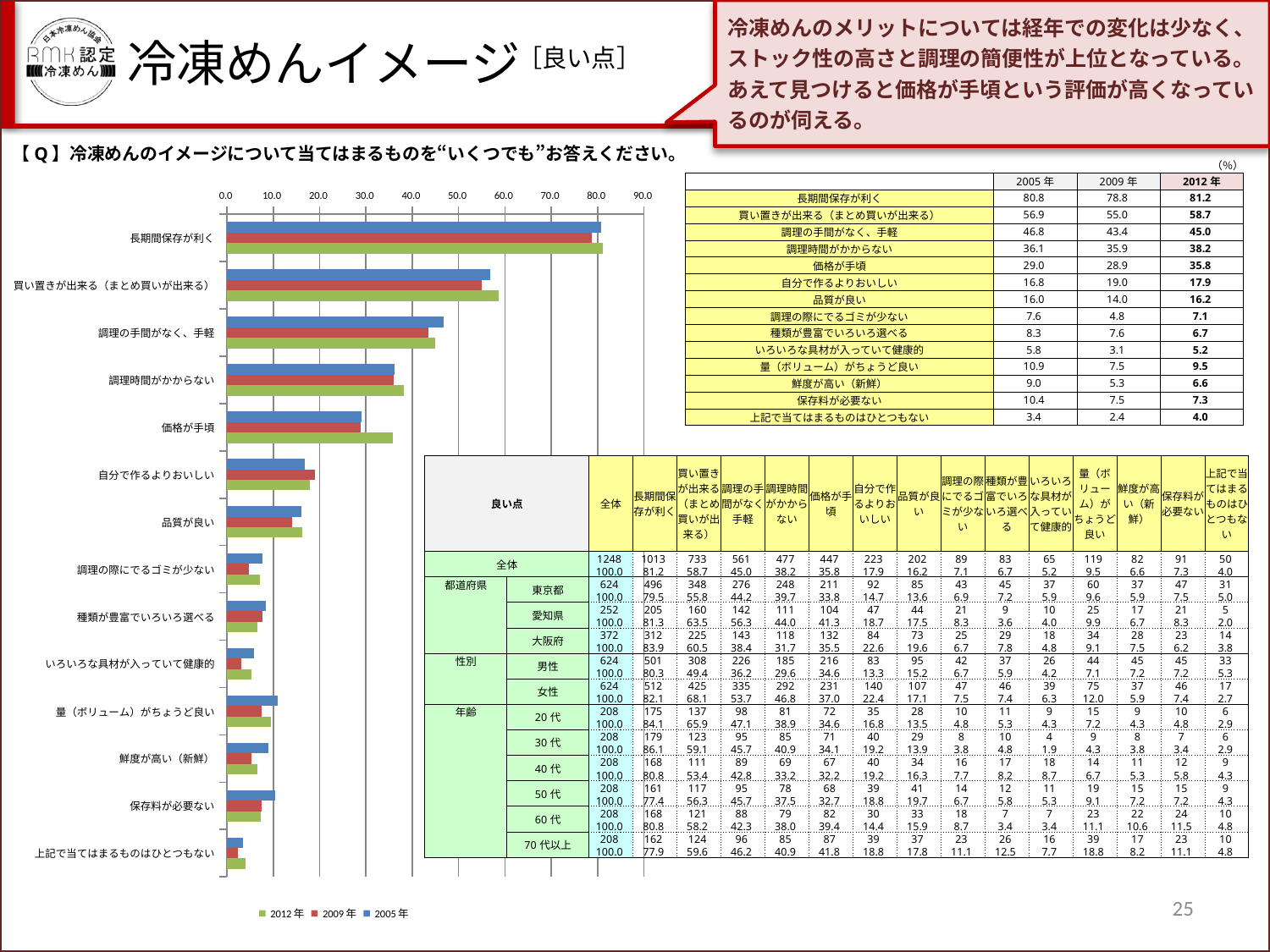
What is the 2012年 value for 長期間保存が利く? 81.2 How many categories are plotted on the bar chart? 14 For 自分で作るよりおいしい, which year has the larger value: 2009年 or 2005年? 2009年 What is the difference between the 2012年 and 2005年 values for 価格が手頃? 6.8 What kind of chart is shown on the left of the slide? bar chart For 2012年, which is larger: 買い置きが出来る（まとめ買いが出来る） or 調理の手間がなく、手軽? 買い置きが出来る（まとめ買いが出来る） What are the three legend entries of the bar chart? 2012年, 2009年, 2005年 Which category has the lowest value for 2012年 in the bar chart? 上記で当てはまるものはひとつもない Which category has the highest value for 2012年 in the bar chart? 長期間保存が利く What is the 2005年 value for 価格が手頃? 29.0 Is the 2012年 value for 調理時間がかからない greater or less than 30.0? greater How many series does the legend of the bar chart list? 3